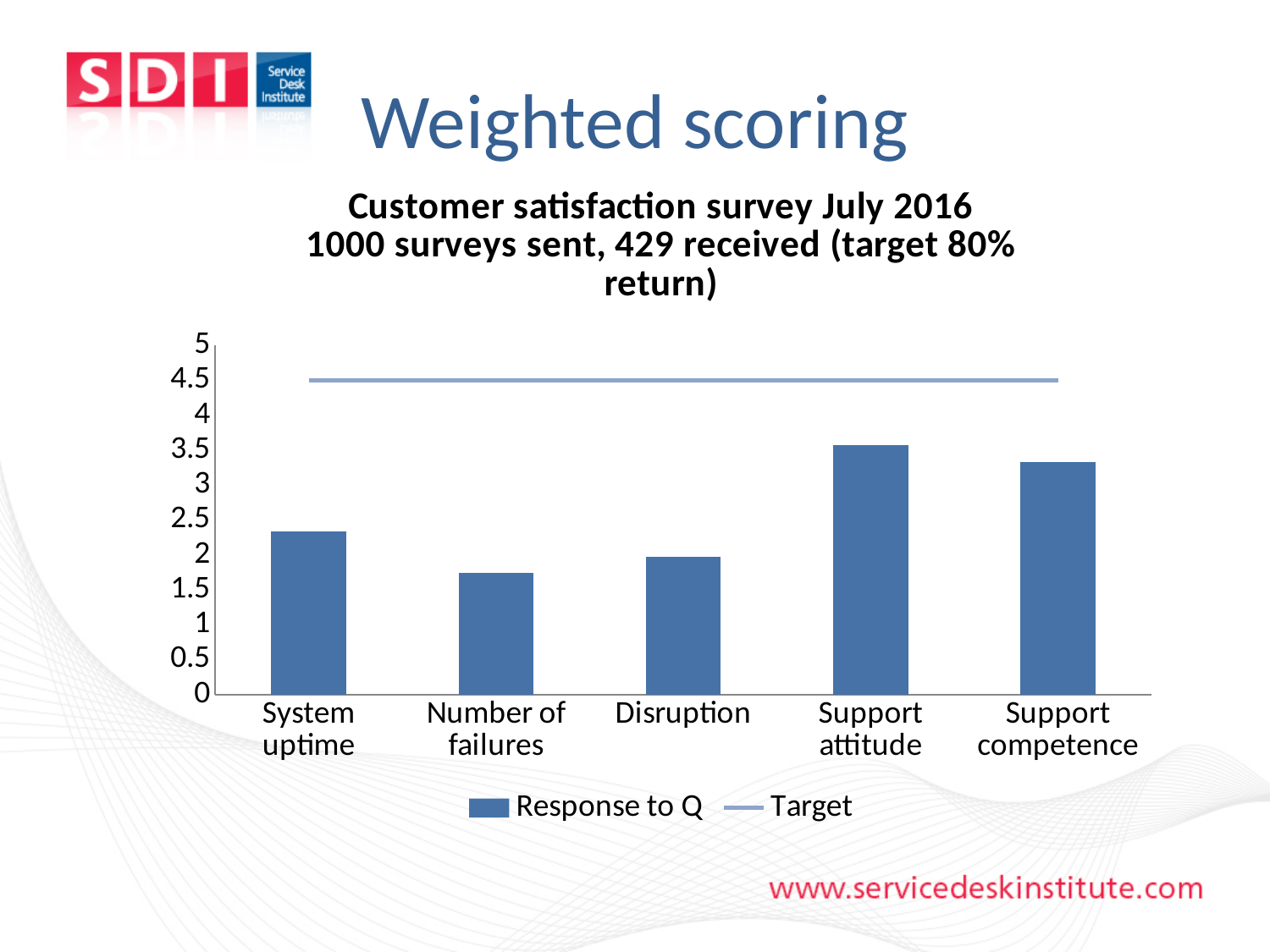
Is the Response to Q value for Support attitude greater or less than 3? greater Which has a larger Response to Q value, System uptime or Disruption? System uptime Which has a larger Response to Q value, Support attitude or Support competence? Support attitude Is the Response to Q value for System uptime greater or less than 2? greater How many categories are shown on the x axis of the chart? 5 Is the Response to Q value for Number of failures greater or less than 2? less Which category has the highest Response to Q value? Support attitude What kind of chart is shown on the slide? bar chart What is the title of the chart? Customer satisfaction survey July 2016 1000 surveys sent, 429 received (target 80% return) Which category has the lowest Response to Q value? Number of failures How many series does the chart's legend list? 2